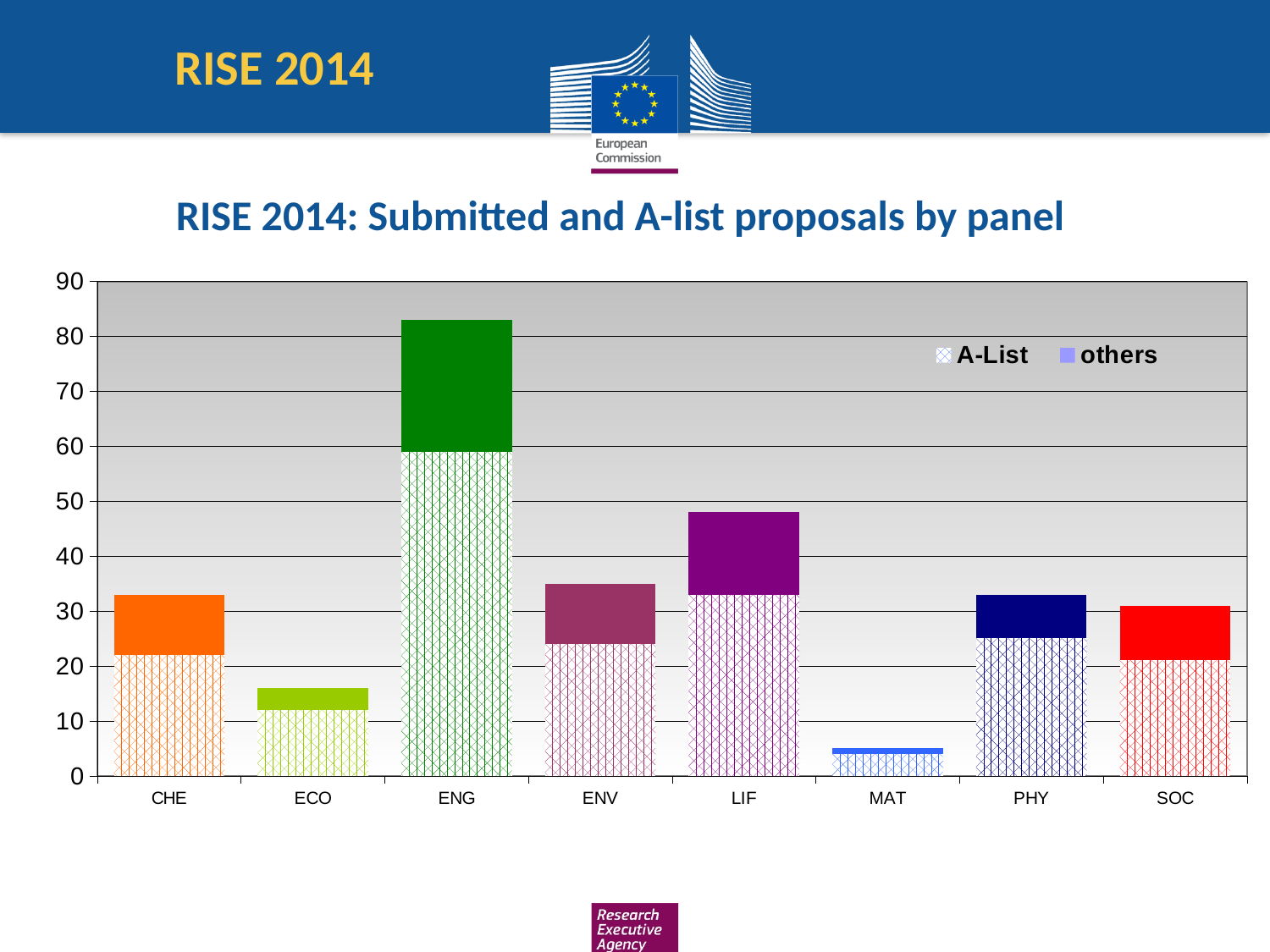
Is the total number of proposals for MAT greater or less than 10? less Is the A-List value for ENG greater or less than 50? greater What kind of chart is shown on the slide? stacked bar chart Which panel has a higher total of proposals, ECO or MAT? ECO What is the title of the chart on the slide? RISE 2014: Submitted and A-list proposals by panel How many panels (categories) are shown on the x axis of the chart? 8 Which panel has a higher total of proposals, LIF or ENV? LIF Is the total number of proposals for LIF greater or less than 40? greater Which panel has the lowest total number of proposals? MAT How many series does the chart legend list? 2 Which panel has the highest total number of proposals? ENG